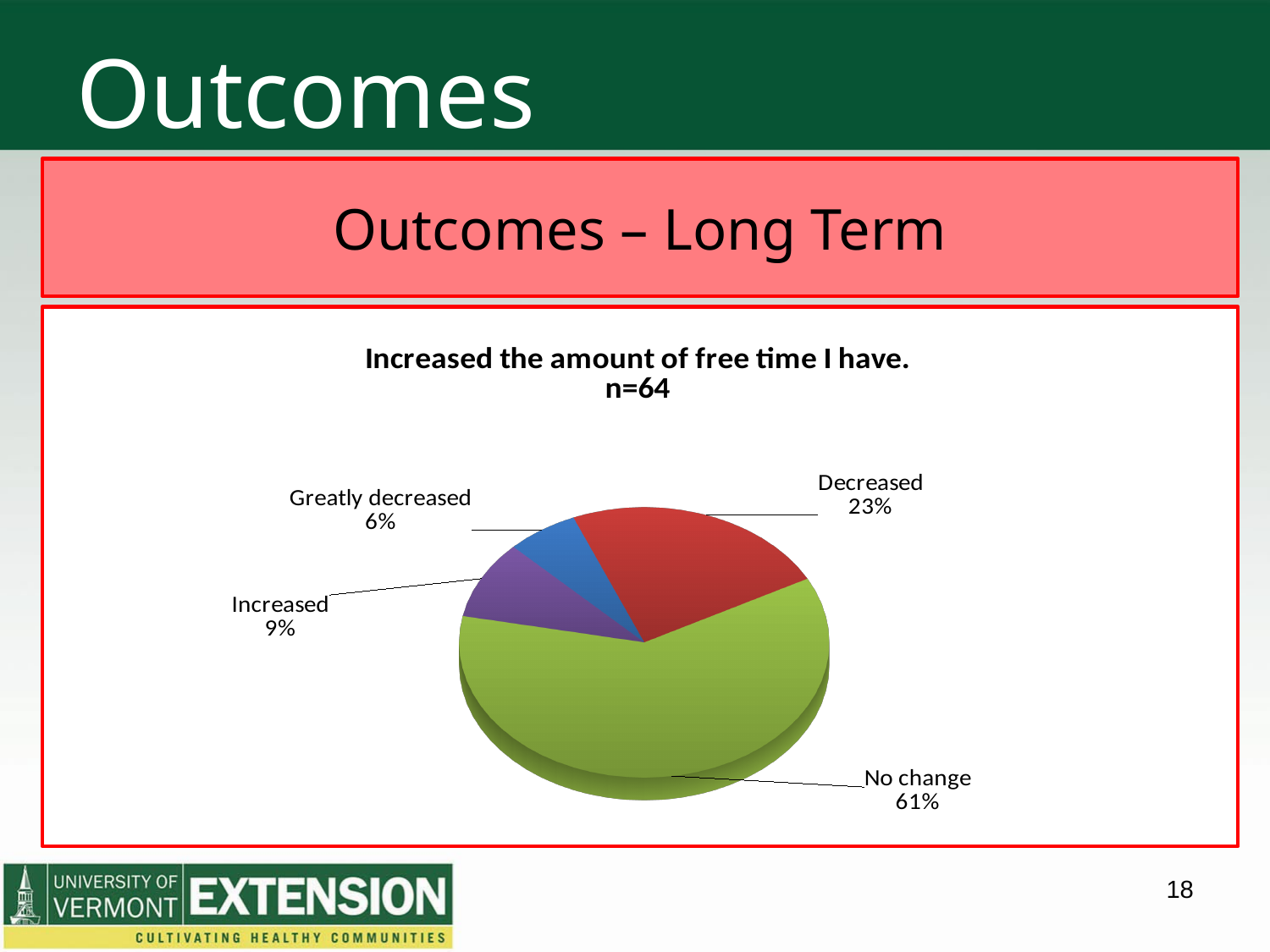
What percentage of respondents reported "No change"? 61% What kind of chart is shown on the slide? pie chart What percentage of respondents reported "Greatly decreased"? 6% How many slices does the pie chart have? 4 Which category has the largest share of the pie? No change What is the title of the chart? Increased the amount of free time I have. n=64 Which category has the smallest share of the pie? Greatly decreased What is the sample size (n) shown in the chart title? 64 What percentage of respondents reported "Increased"? 9% What percentage of respondents reported "Decreased"? 23% Which is larger, the share for "Increased" or the share for "Greatly decreased"? Increased What is the difference in percentage points between "No change" and "Decreased"? 38